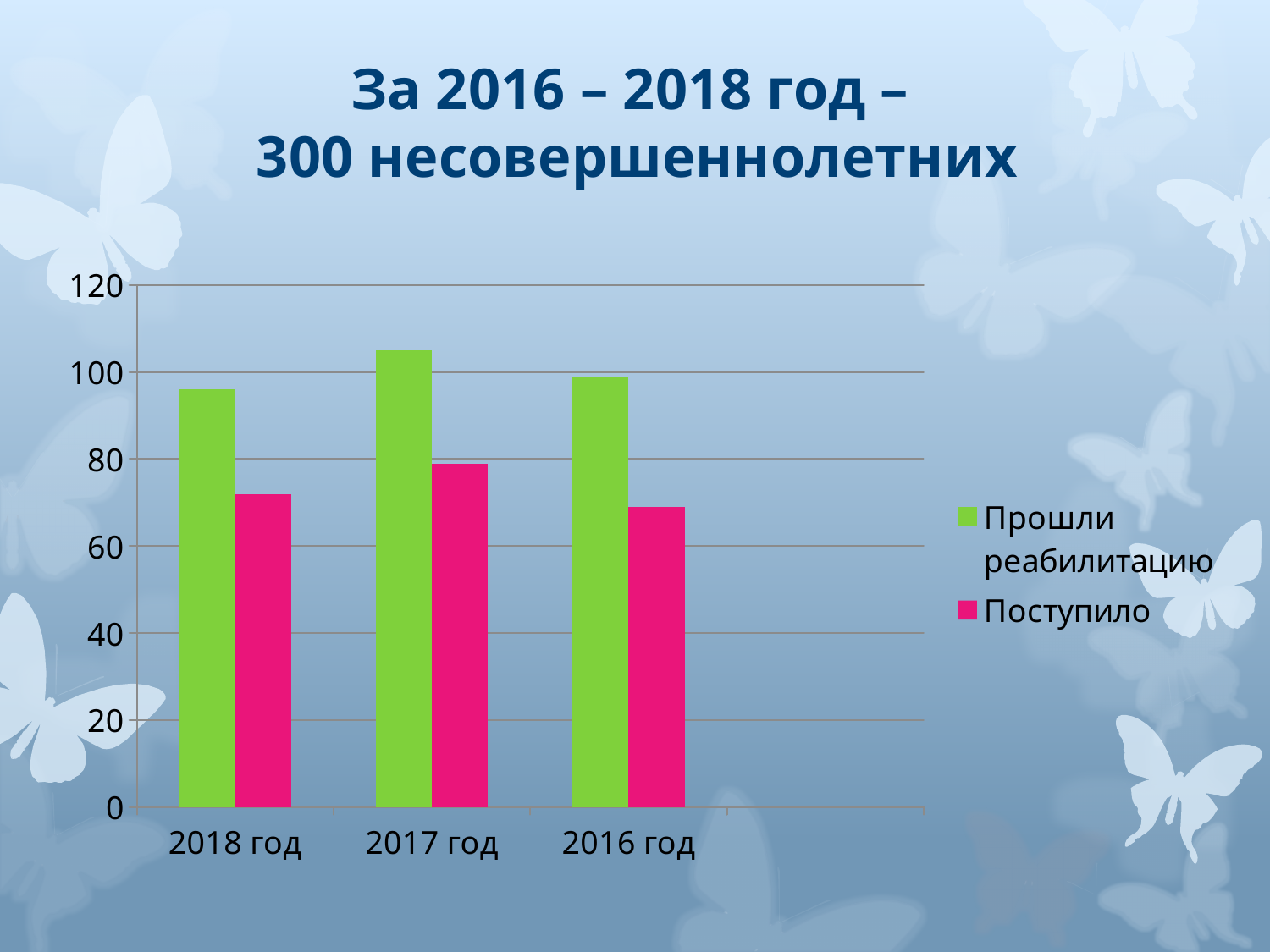
Is the value for Прошли реабилитацию in 2017 год greater or less than 100? greater Which colour represents the Поступило series? pink Which year has the highest value for Прошли реабилитацию? 2017 год Is the value for Поступило in 2018 год greater or less than 80? less Is the value for Поступило in 2016 год greater or less than 60? greater What kind of chart is shown on the slide? bar chart Which year has the highest value for Поступило? 2017 год How many year categories are shown on the x axis? 3 In 2016 год, which is larger: Прошли реабилитацию or Поступило? Прошли реабилитацию How many series does the legend list? 2 What is the title of the slide above the chart? За 2016 – 2018 год – 300 несовершеннолетних